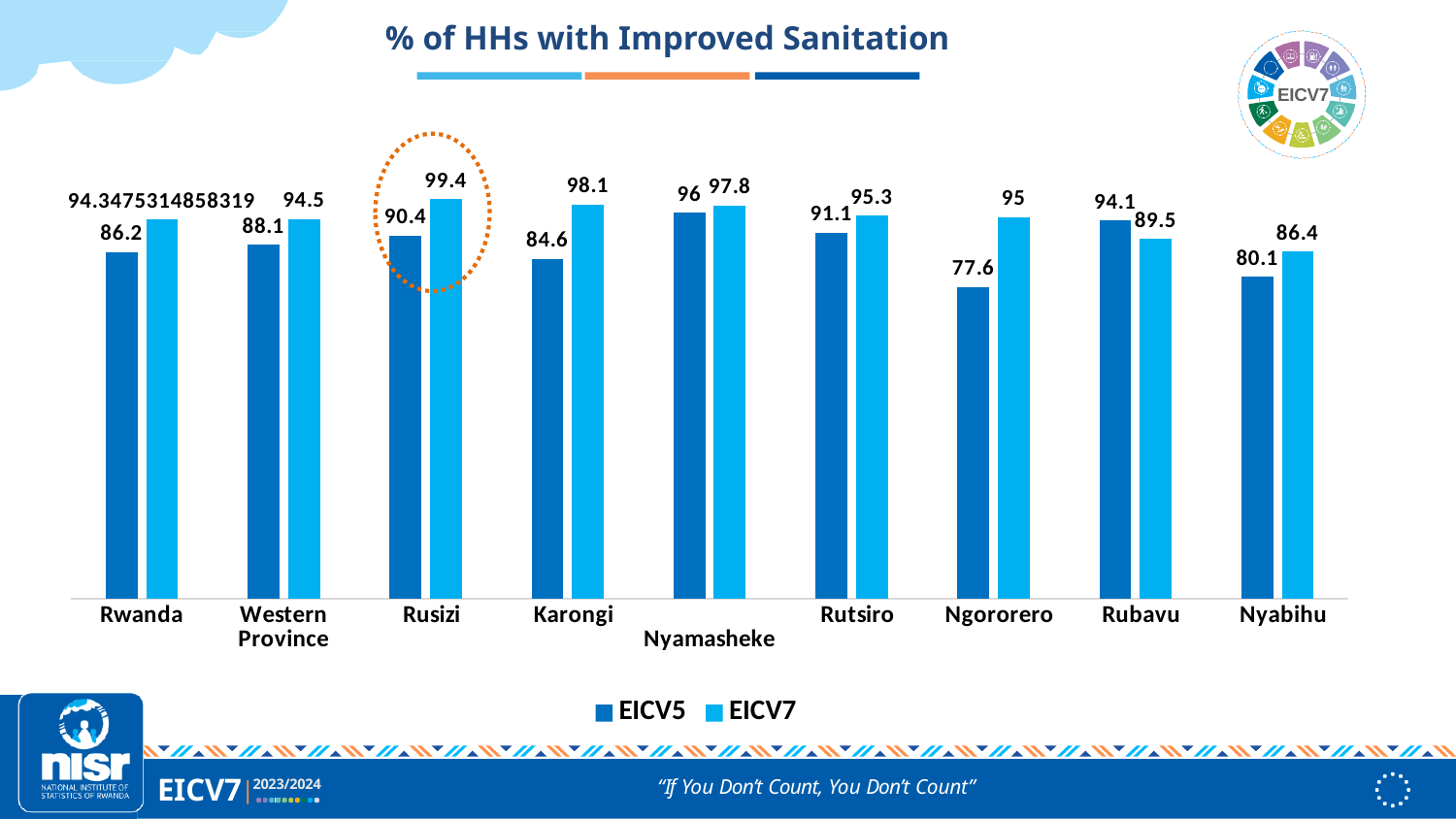
What is the EICV7 value for Rusizi? 99.4 What is the difference between the EICV7 and EICV5 values for Karongi? 13.5 Which category has the lowest EICV5 value? Ngororero What is the difference between the EICV7 and EICV5 values for Ngororero? 17.4 What kind of chart is shown on the slide? Bar chart How many series does the legend list? 2 What is the EICV5 value for Ngororero? 77.6 Which category has the highest EICV7 value? Rusizi What is the EICV5 value for Nyamasheke? 96 Which category has the highest EICV5 value? Nyamasheke How many categories are shown on the x axis? 9 For Rubavu, which is larger, the EICV5 value or the EICV7 value? EICV5